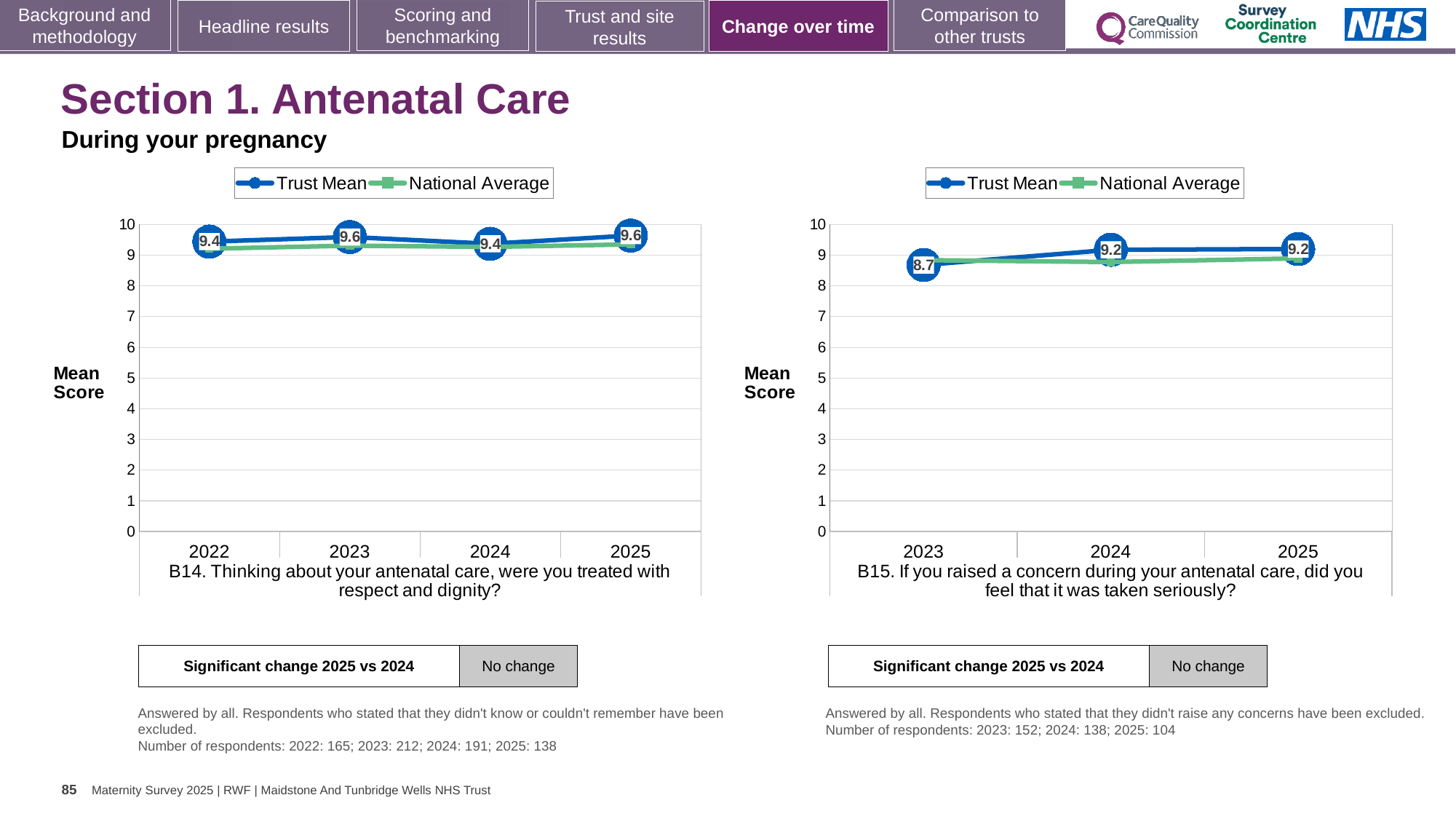
On the B15 chart (right), what is the Trust Mean for 2023? 8.7 On the B15 chart (right), what is the Trust Mean for 2025? 9.2 On the B14 chart (left), is the Trust Mean for 2023 larger or smaller than the Trust Mean for 2024? larger On the B15 chart (right), which year has the lowest Trust Mean? 2023 How many series does the legend of the B14 chart (left) list? 2 What kind of chart is the B14 chart (left)? line chart On the B14 chart (left), what is the difference between the Trust Mean for 2023 and 2022? 0.2 On the B14 chart (left), is the National Average for 2022 greater or less than 8? greater On the B14 chart (left), what is the Trust Mean for 2022? 9.4 On the B15 chart (right), what is the difference between the Trust Mean for 2024 and 2023? 0.5 On the B14 chart (left), what is the Trust Mean for 2025? 9.6 How many years are shown on the x axis of the B15 chart (right)? 3